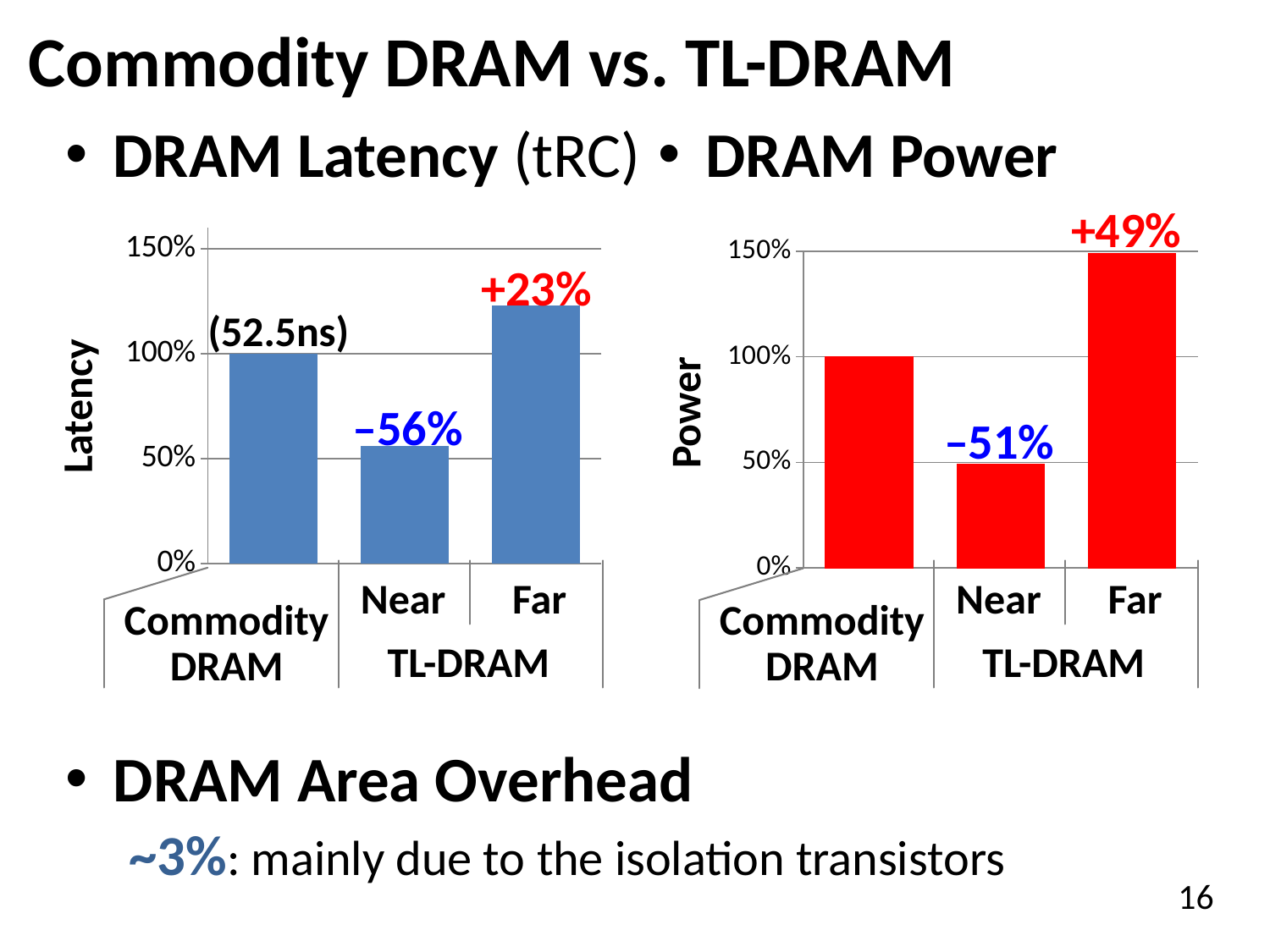
In the DRAM Latency chart, what percentage change is labelled on the TL-DRAM Near bar? –56% In the DRAM Power chart, what percentage change is labelled on the TL-DRAM Far bar? +49% What colour are the bars in the DRAM Power chart? Red In the DRAM Latency chart, what value is printed above the Commodity DRAM bar? (52.5ns) In the DRAM Latency chart, what percentage change is labelled on the TL-DRAM Far bar? +23% In the DRAM Latency chart, which bar is the tallest? Far What kind of chart is the DRAM Latency chart? Bar chart In the DRAM Power chart, which bar is the shortest? Near How many bars are plotted in the DRAM Power chart? 3 In the DRAM Latency chart, is the value for the TL-DRAM Near bar greater or less than 50%? greater In the DRAM Power chart, is the value for the TL-DRAM Far bar greater or less than 100%? greater In the DRAM Power chart, what percentage change is labelled on the TL-DRAM Near bar? –51%